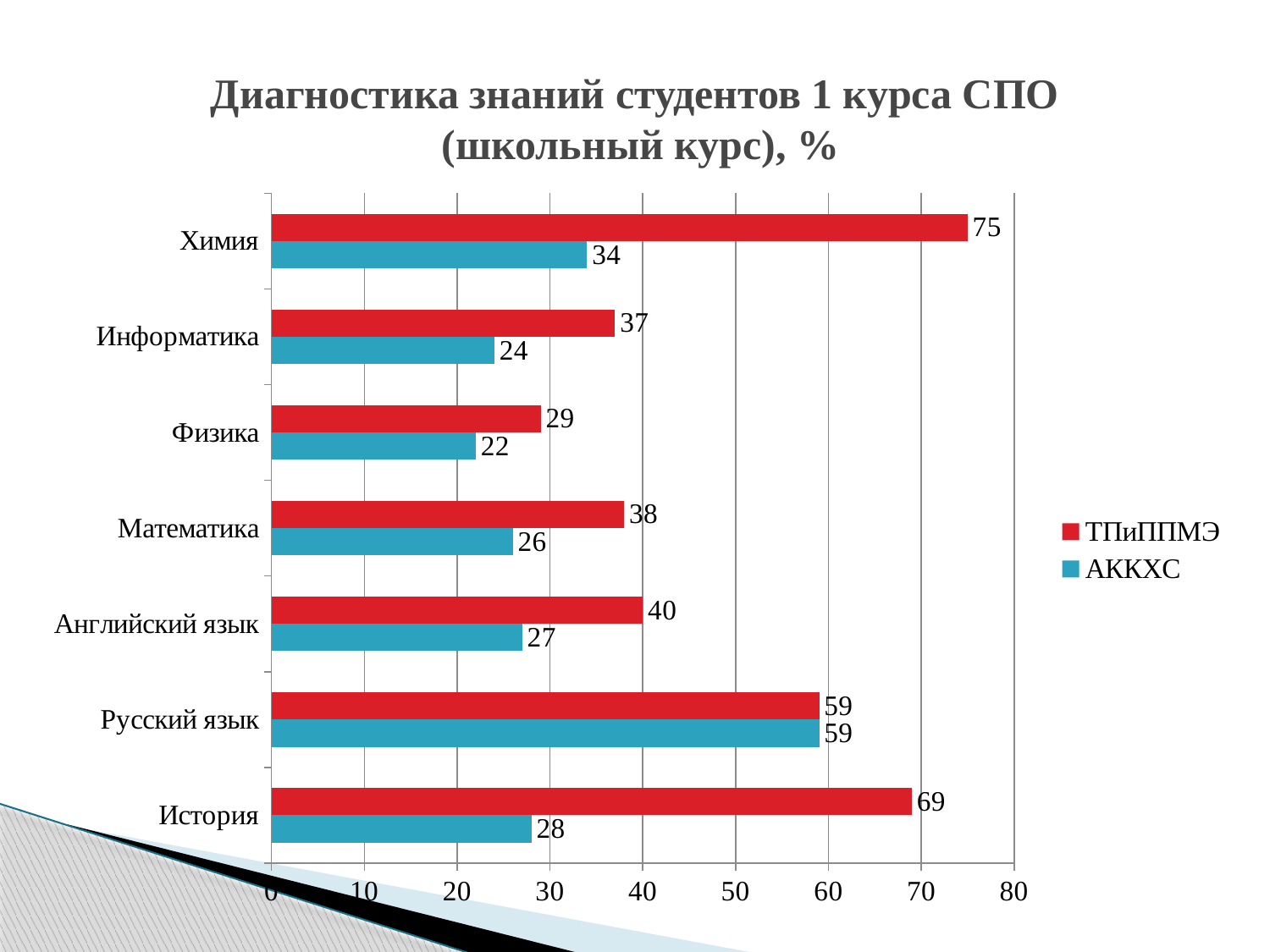
What kind of chart is shown on the slide? bar chart Which is larger for Информатика: the ТПиППМЭ value or the АККХС value? ТПиППМЭ How many categories are shown on the chart? 7 Which category has the lowest value for АККХС? Физика Is the value for ТПиППМЭ in История greater or less than 60? greater Which category has the highest value for ТПиППМЭ? Химия What is the value for АККХС in Математика? 26 How many series does the legend list? 2 What is the value for ТПиППМЭ in Химия? 75 What is the value for АККХС in История? 28 Which colour represents АККХС in the legend? blue What is the difference between the ТПиППМЭ and АККХС values for Химия? 41